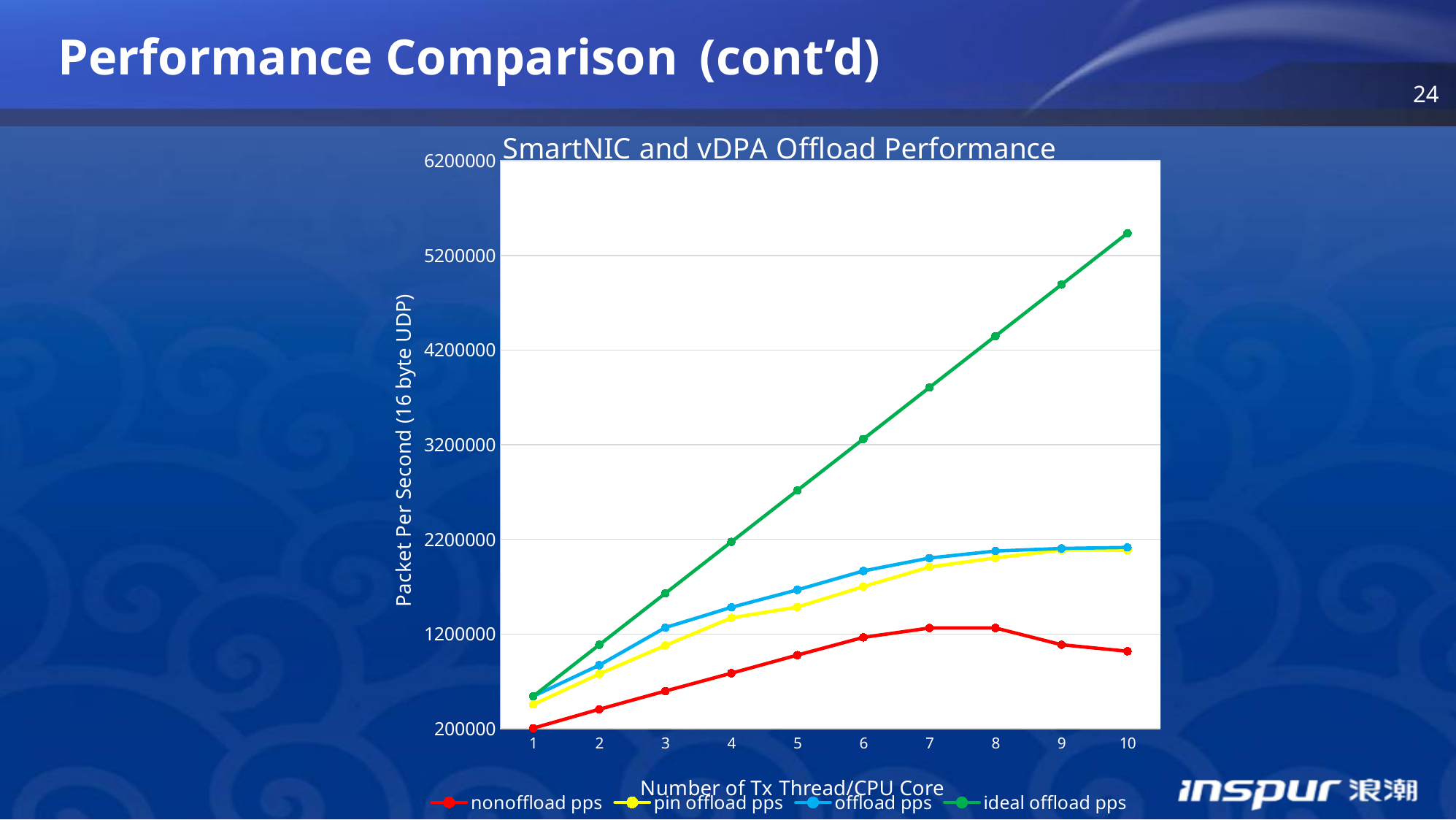
Is the value for ideal offload pps at 10 Tx threads greater or less than 5200000? greater Which series has the lowest value at 10 Tx threads? nonoffload pps What is the title of the chart? SmartNIC and vDPA Offload Performance Is the value for nonoffload pps at 10 Tx threads greater or less than 1200000? less What is the label of the y axis? Packet Per Second (16 byte UDP) Is the value for ideal offload pps at 8 Tx threads greater or less than 4200000? greater Does the ideal offload pps series rise or fall as the number of Tx threads increases from 1 to 10? rise Which series has the highest value at 10 Tx threads? ideal offload pps How many series does the legend list? 4 How many points along the x axis does each series have? 10 What kind of chart is shown on the slide? line chart